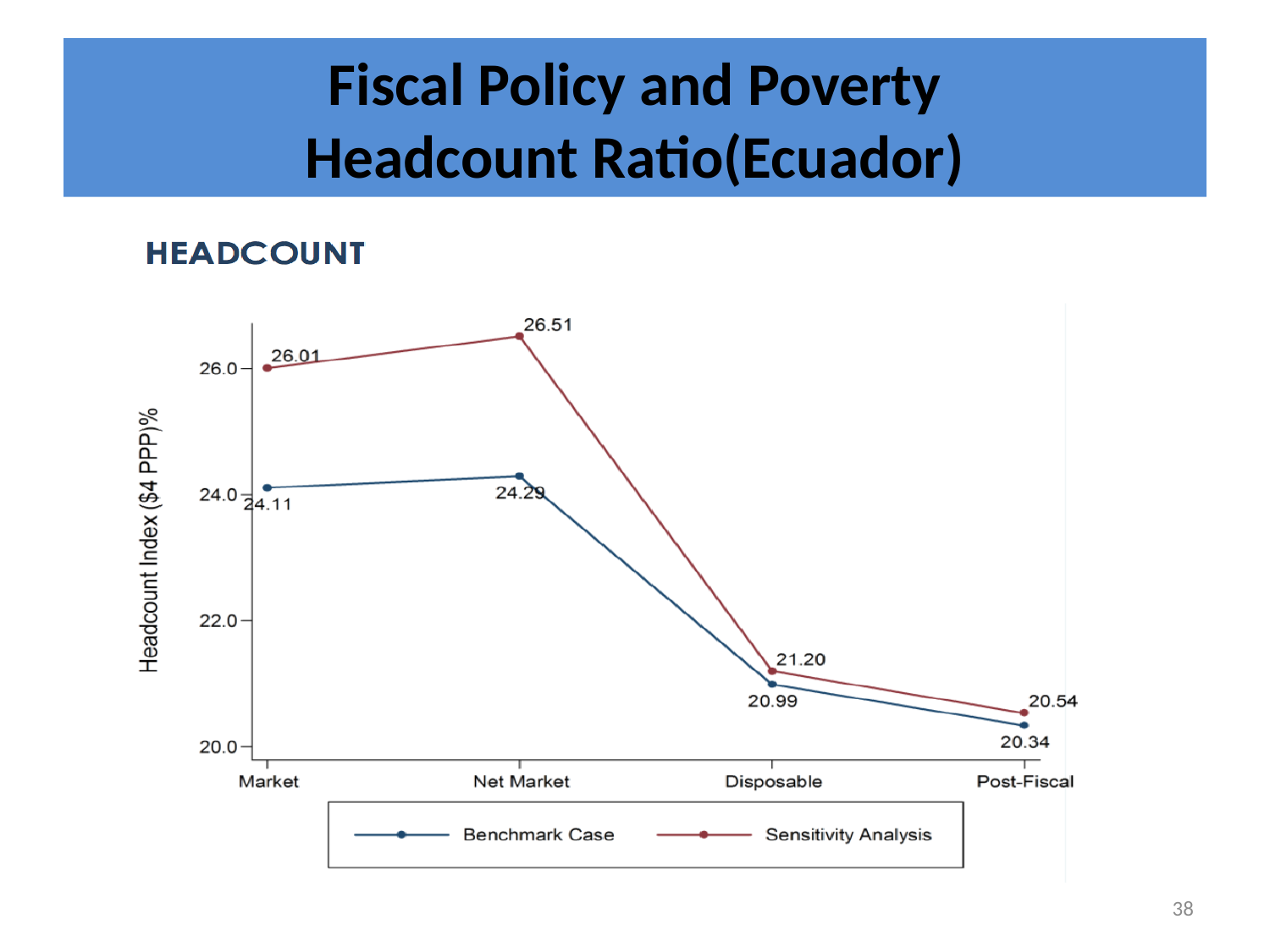
How many series does the legend list? 2 What is the difference between the Sensitivity Analysis and Benchmark Case values for Market? 1.90 How many categories are shown on the x axis? 4 What kind of chart is shown? line chart What is the Sensitivity Analysis value for Disposable? 21.20 Which category has the lowest Benchmark Case value? Post-Fiscal What is the Sensitivity Analysis value for Net Market? 26.51 Do the Benchmark Case values rise or fall from Net Market to Post-Fiscal? fall Which is larger, the Benchmark Case value for Net Market or the Benchmark Case value for Disposable? Net Market What is the Benchmark Case value for Market? 24.11 Which category has the highest Sensitivity Analysis value? Net Market What is the Benchmark Case value for Post-Fiscal? 20.34